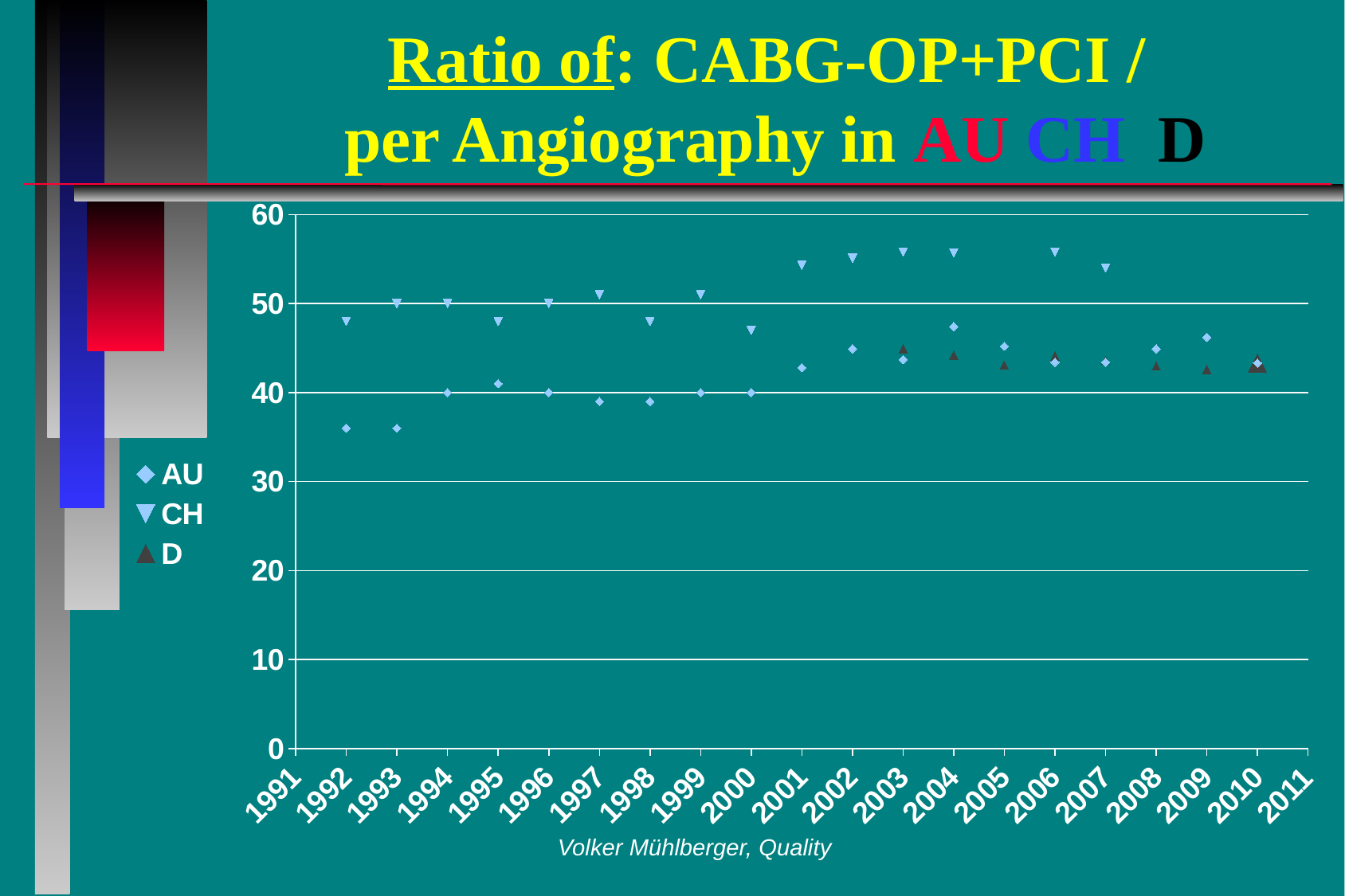
Is the value for AU in 1992 greater or less than 40? less In 1992, which series has the larger value, AU or CH? CH Is the value for D in 2005 greater or less than 40? greater In 2003, which series has the larger value, CH or AU? CH Is the value for CH in 2000 greater or less than 50? less How many year labels are shown on the x axis? 21 Which series are listed in the legend? AU, CH, D Do the AU values generally rise or fall from 1992 to 2009? rise What kind of chart is shown on the slide? scatter chart How many series does the legend list? 3